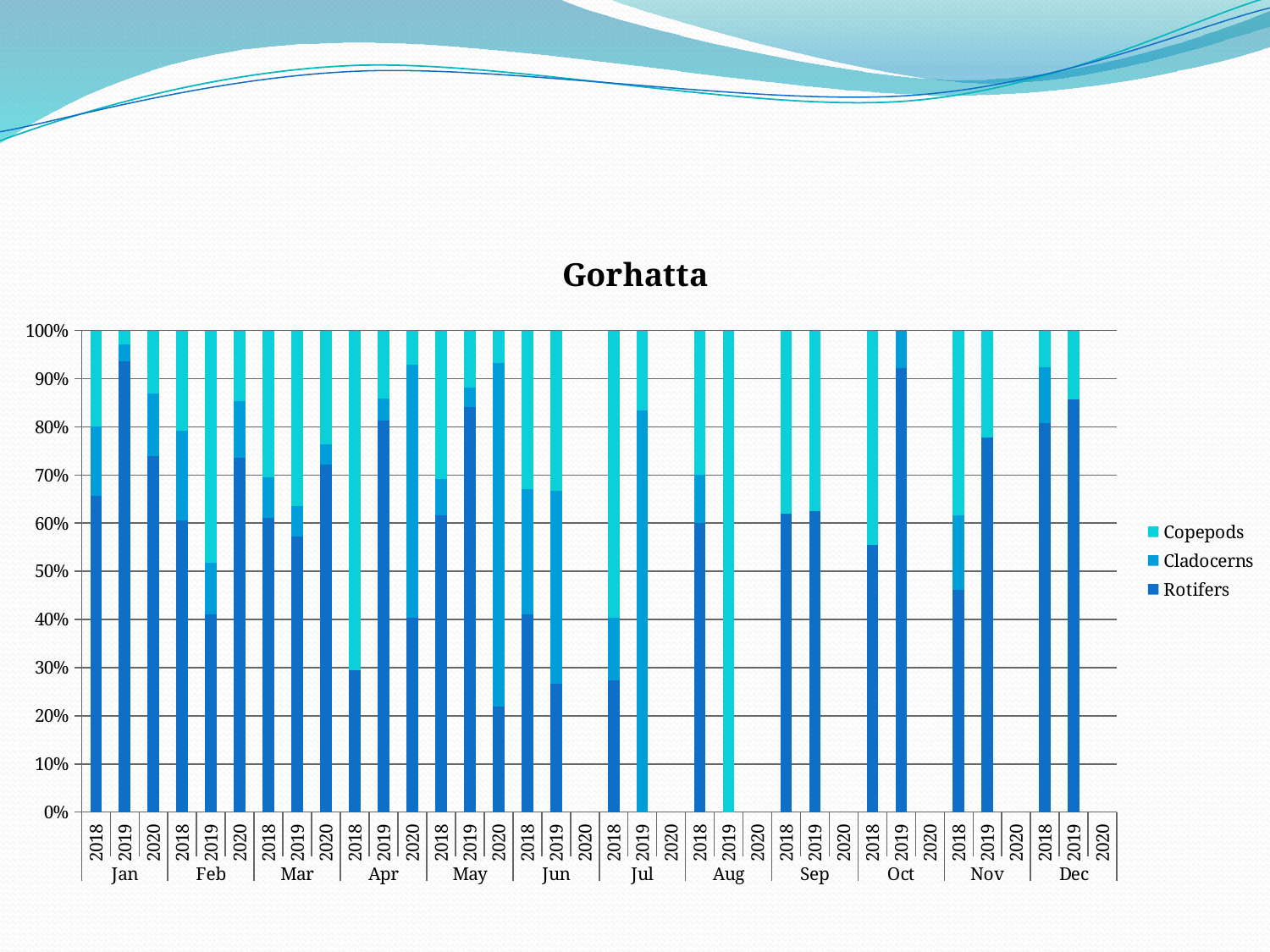
How many months are shown along the x axis? 12 What is the title of the chart? Gorhatta Is the Rotifers value for Apr 2018 greater or less than 40%? less Which series are listed in the legend? Copepods, Cladocerns, Rotifers Is the Rotifers value for Oct 2019 greater or less than 90%? greater What does each stacked bar total, as shown by the top of the y axis? 100% Is the Rotifers value for May 2020 greater or less than 30%? less Which is larger, the Rotifers value for Nov 2018 or for Nov 2019? Nov 2019 Which is larger, the Rotifers value for Jan 2018 or for Jan 2019? Jan 2019 What kind of chart is shown on the slide? Stacked bar chart How many series does the legend list? 3